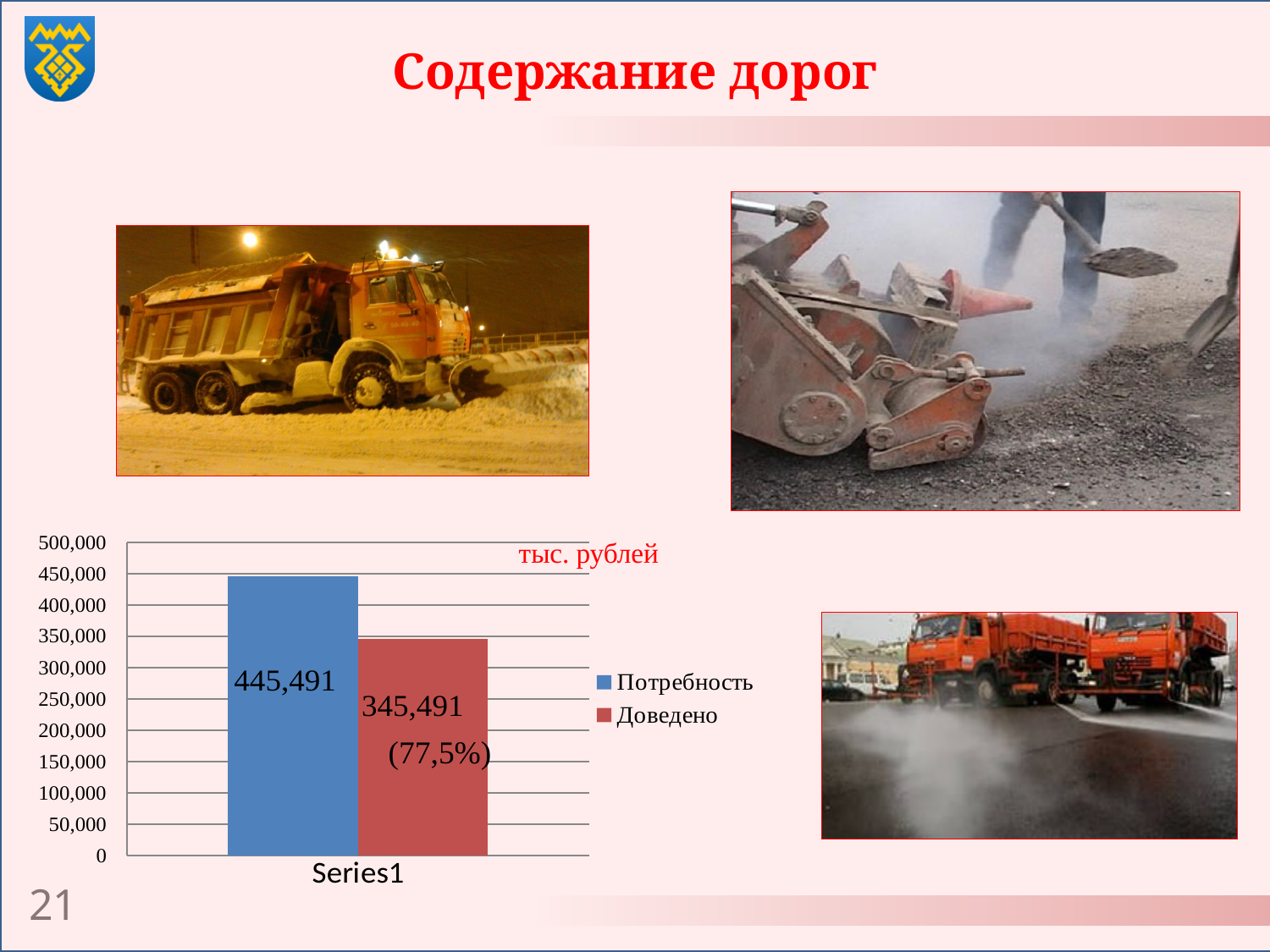
What colour is the Потребность bar? blue Is the value for Доведено greater or less than 400,000? less Is the value for Потребность greater or less than 400,000? greater What unit label is printed on the chart? тыс. рублей Which series has the lowest value on the chart? Доведено What is the value of the Доведено bar? 345,491 What is the difference between the Потребность and Доведено values? 100,000 What is the value of the Потребность bar? 445,491 Which series has the higher value, Потребность or Доведено? Потребность What percentage is printed next to the Доведено bar? (77,5%) What kind of chart is shown on the slide? bar chart How many series does the legend list? 2